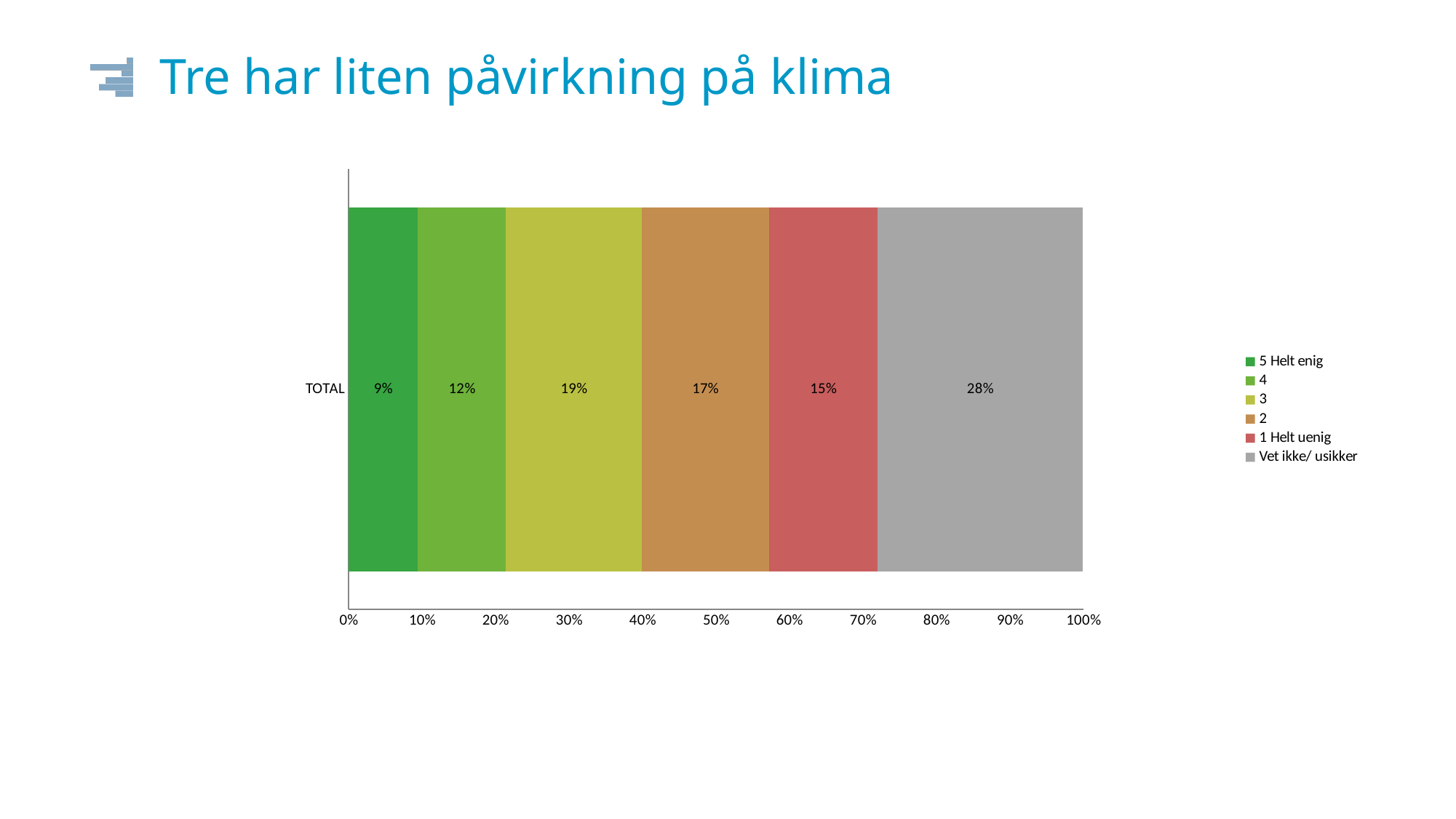
Which response category has the smallest share? 5 Helt enig Which is larger, the share for "4" or the share for "2"? 2 What is the combined share of "5 Helt enig" and "4"? 21% What kind of chart is shown on the slide? Stacked bar chart What is the difference between the "Vet ikke/ usikker" share and the "5 Helt enig" share? 19% How many series does the legend list? 6 Which response category has the largest share? Vet ikke/ usikker What is the value for "1 Helt uenig"? 15% What percentage answered "3"? 19% What percentage of respondents answered "5 Helt enig"? 9% What is the value for the "Vet ikke/ usikker" segment? 28% What is the title of the slide? Tre har liten påvirkning på klima